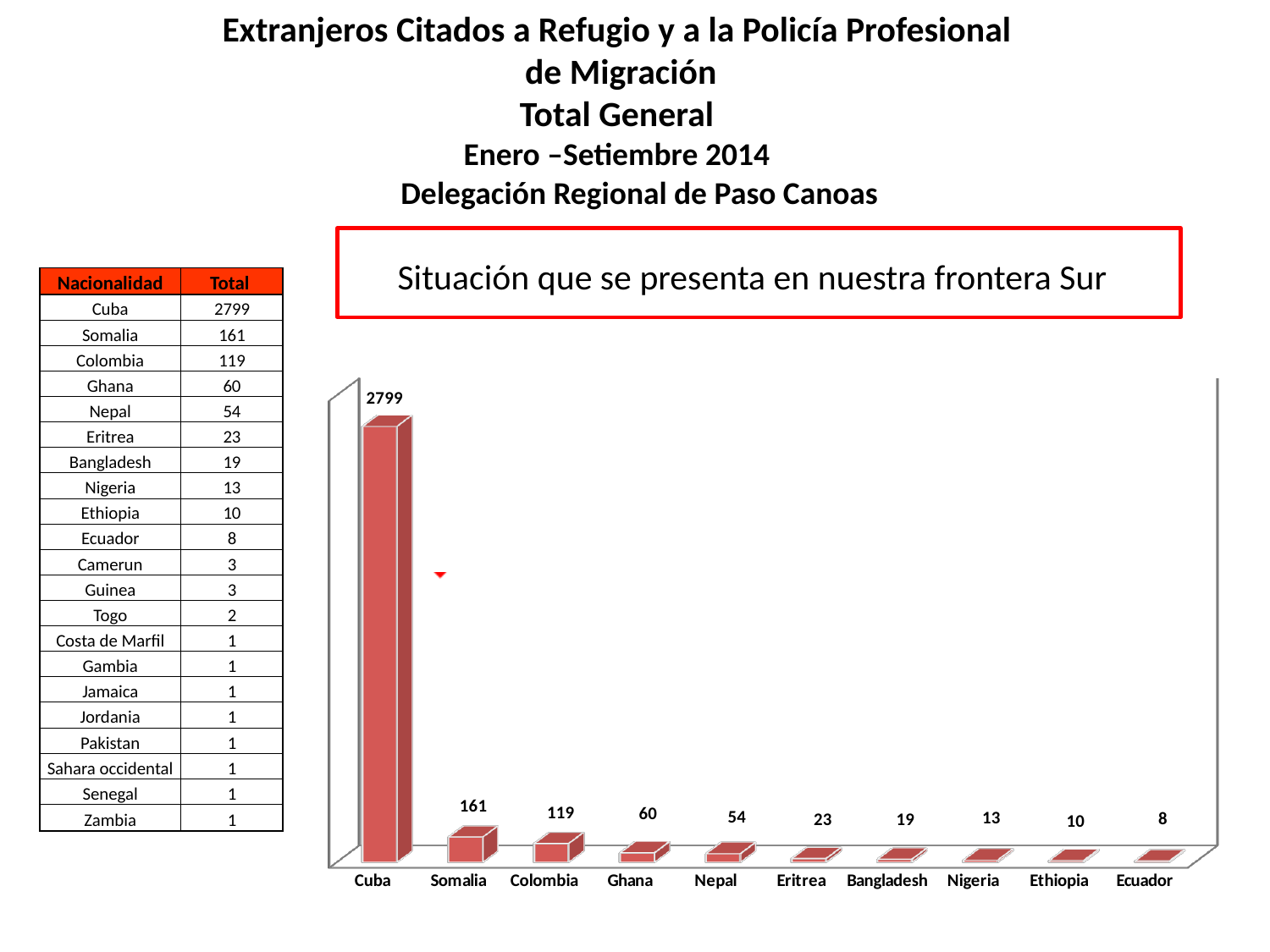
What is the value shown for Cuba in the bar chart? 2799 What kind of chart is shown on the slide? Bar chart What is the difference between the values for Somalia and Colombia in the bar chart? 42 Do the values in the bar chart rise or fall from left to right along the x axis? Fall Which category has the highest value in the bar chart? Cuba What is the difference between the values for Ghana and Nepal in the bar chart? 6 What is the value shown for Somalia in the bar chart? 161 Which has a larger value in the bar chart, Eritrea or Bangladesh? Eritrea What is the value shown for Ecuador in the bar chart? 8 Which category has the lowest value in the bar chart? Ecuador What is the value shown for Nepal in the bar chart? 54 How many categories are shown on the x axis of the bar chart? 10